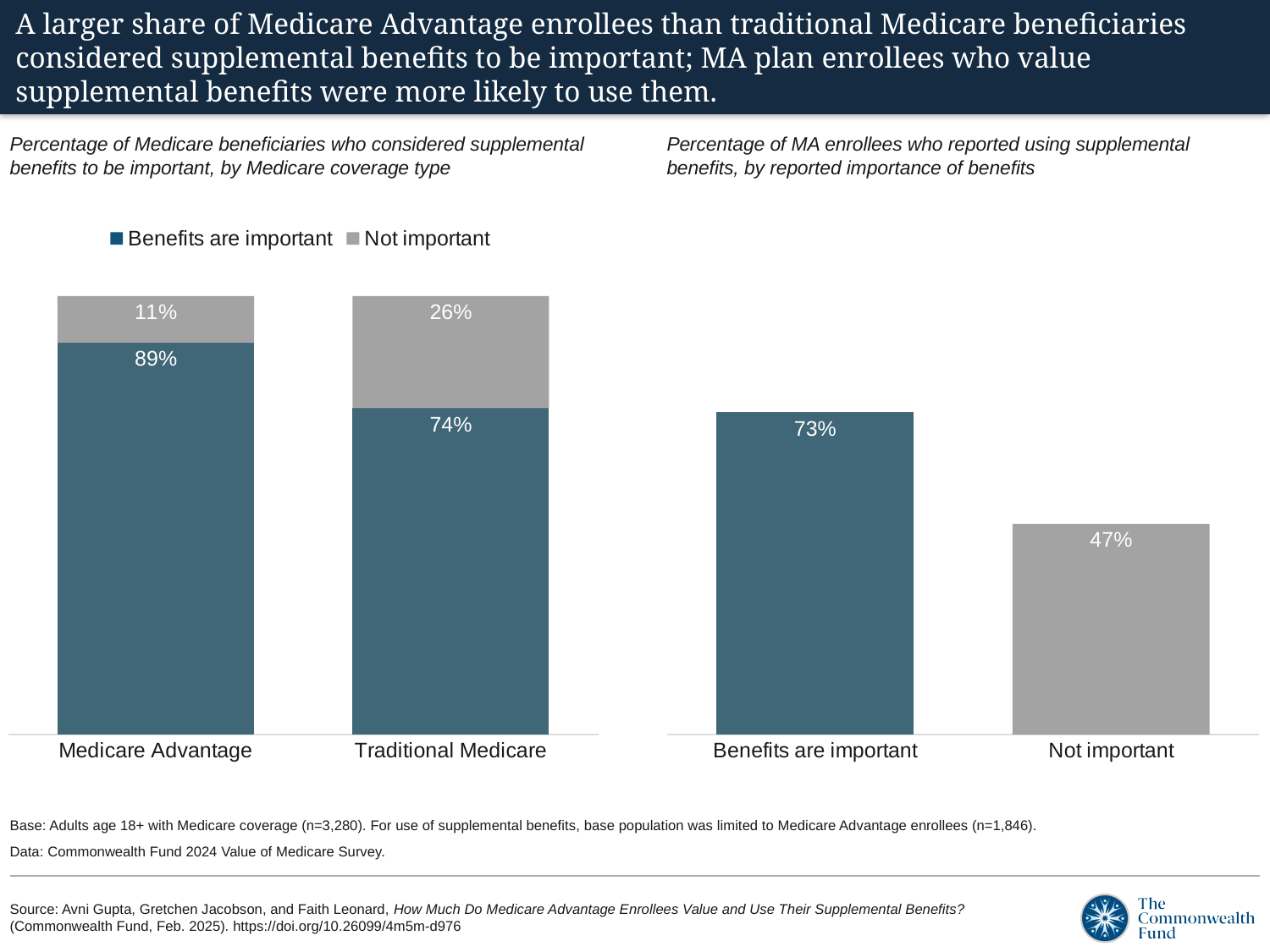
What kind of chart is the left chart? Stacked bar chart In the right chart, which category has the lower value? Not important In the left chart, what is the difference between the 'Benefits are important' share for Medicare Advantage and for Traditional Medicare? 15 percentage points In the right chart, what is the difference between the 'Benefits are important' and 'Not important' values? 26 percentage points In the left chart, which coverage type has the larger 'Not important' share? Traditional Medicare In the left chart, what is the total of the stacked bar for Medicare Advantage? 100% In the left chart, what percentage of Traditional Medicare beneficiaries said benefits are important? 74% In the left chart, what percentage of Traditional Medicare beneficiaries said benefits are not important? 26% In the right chart, what percentage of those who said benefits are not important reported using them? 47% In the left chart (percentage who considered supplemental benefits important, by coverage type), what percentage of Medicare Advantage enrollees said benefits are important? 89% In the right chart (percentage of MA enrollees who reported using supplemental benefits), what percentage of those who said benefits are important reported using them? 73% How many series does the legend of the left chart list? 2